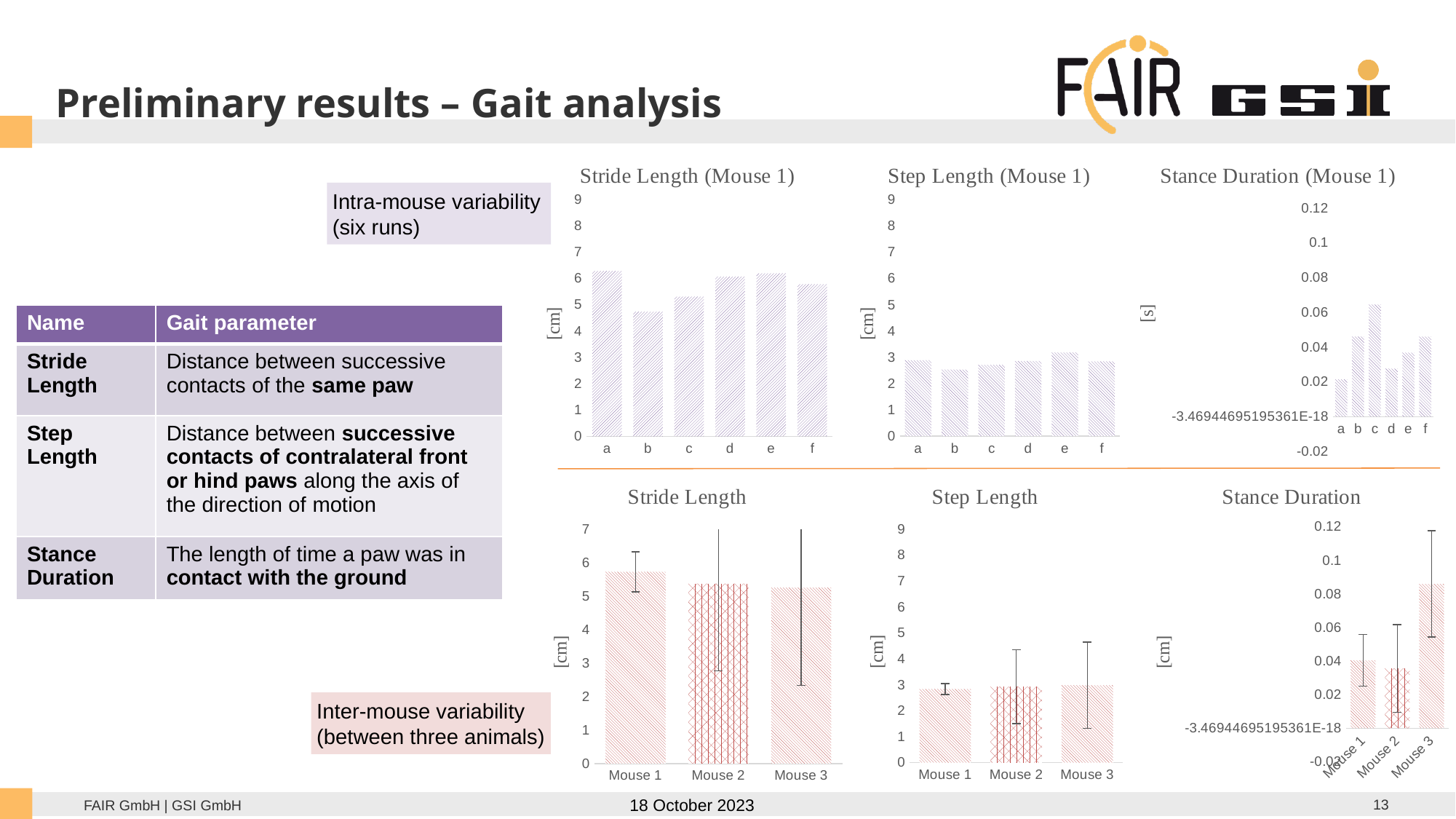
In the Stride Length (Mouse 1) chart, is the value for run a greater or less than 6? greater In the Step Length (Mouse 1) chart, is the value for run e greater or less than 3? greater In the bottom Stride Length chart, which mouse has the highest stride length? Mouse 1 In the Stance Duration (Mouse 1) chart, which run has the highest stance duration? c What type of chart is the bottom Step Length chart? bar chart In the Stance Duration (Mouse 1) chart, is the value for run c greater or less than 0.06? greater How many runs are plotted in the Step Length (Mouse 1) chart? 6 In the bottom Stance Duration chart, which mouse has the highest stance duration? Mouse 3 In the Stride Length (Mouse 1) chart, which run has the lowest stride length? b